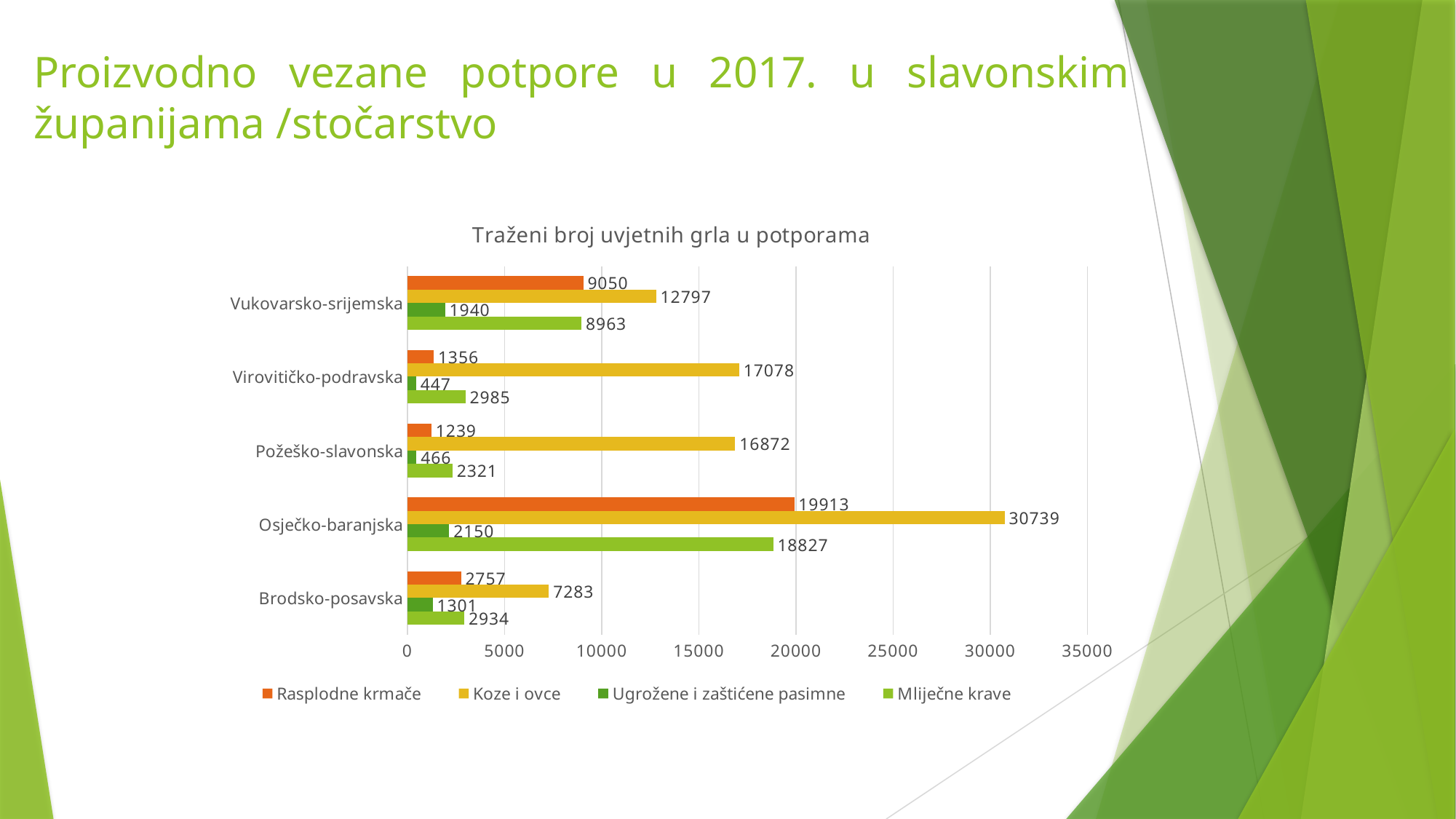
How many series does the legend list? 4 What is the value for Ugrožene i zaštićene pasimne in Virovitičko-podravska? 447 What is the title of the chart? Traženi broj uvjetnih grla u potporama Which county has the lowest value for Koze i ovce? Brodsko-posavska What is the value for Rasplodne krmače in Vukovarsko-srijemska? 9050 What is the value for Mliječne krave in Brodsko-posavska? 2934 Which is larger: Rasplodne krmače in Brodsko-posavska or Rasplodne krmače in Požeško-slavonska? Brodsko-posavska How many counties are shown on the chart? 5 What is the value for Koze i ovce in Osječko-baranjska? 30739 What is the difference between Koze i ovce in Osječko-baranjska and in Vukovarsko-srijemska? 17942 What kind of chart is shown on the slide? Bar chart Which county has the highest value for Mliječne krave? Osječko-baranjska